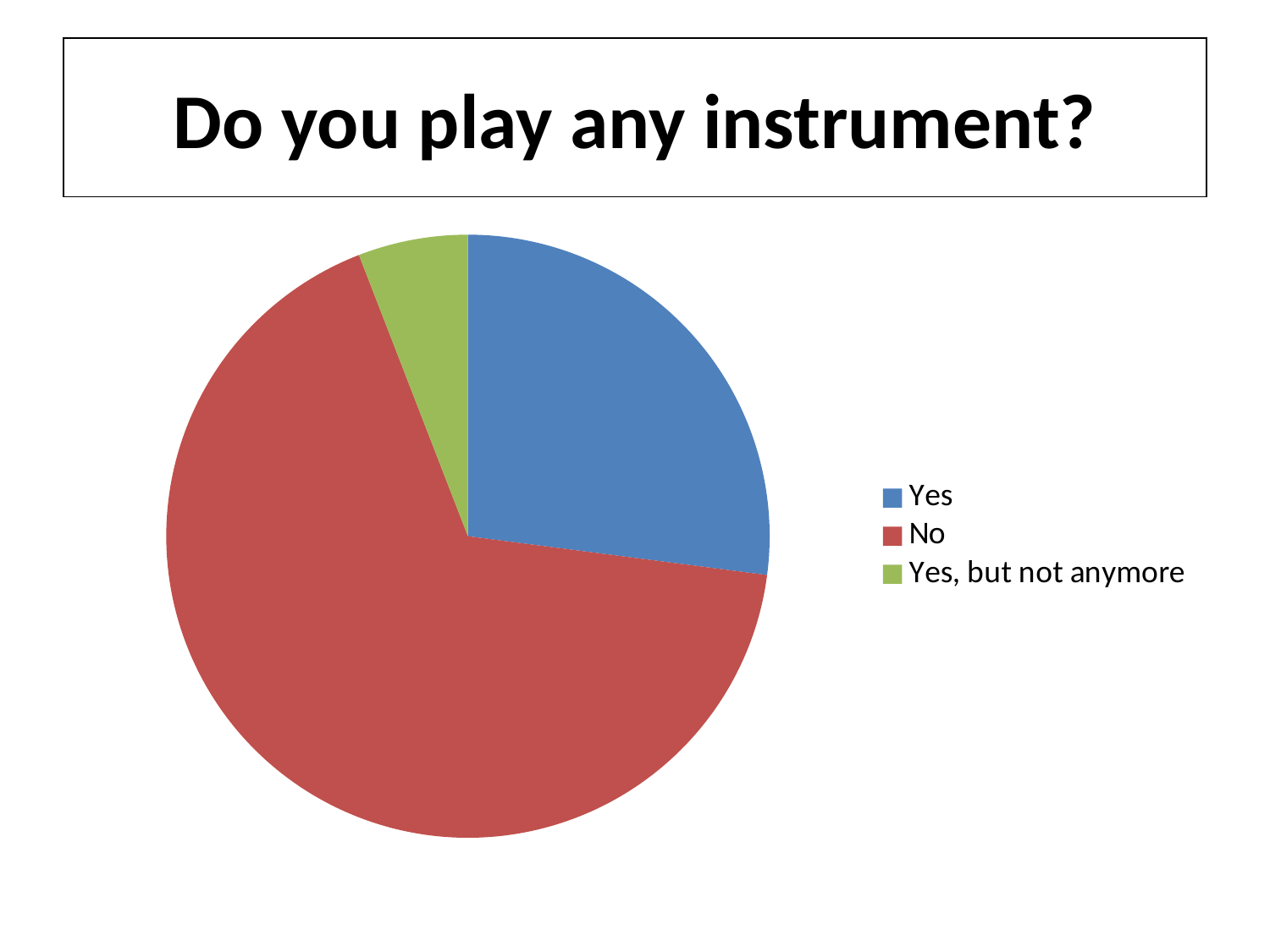
Does the Yes slice take up more or less than half of the pie? less How many categories does the legend list? 3 What is the title of the chart? Do you play any instrument? Which slice is larger, Yes or Yes, but not anymore? Yes Does the No slice take up more or less than half of the pie? more What colour is the slice for No? red What kind of chart is shown on the slide? pie chart Which category has the smallest slice of the pie? Yes, but not anymore Which slice is larger, Yes or No? No Which category has the largest slice of the pie? No